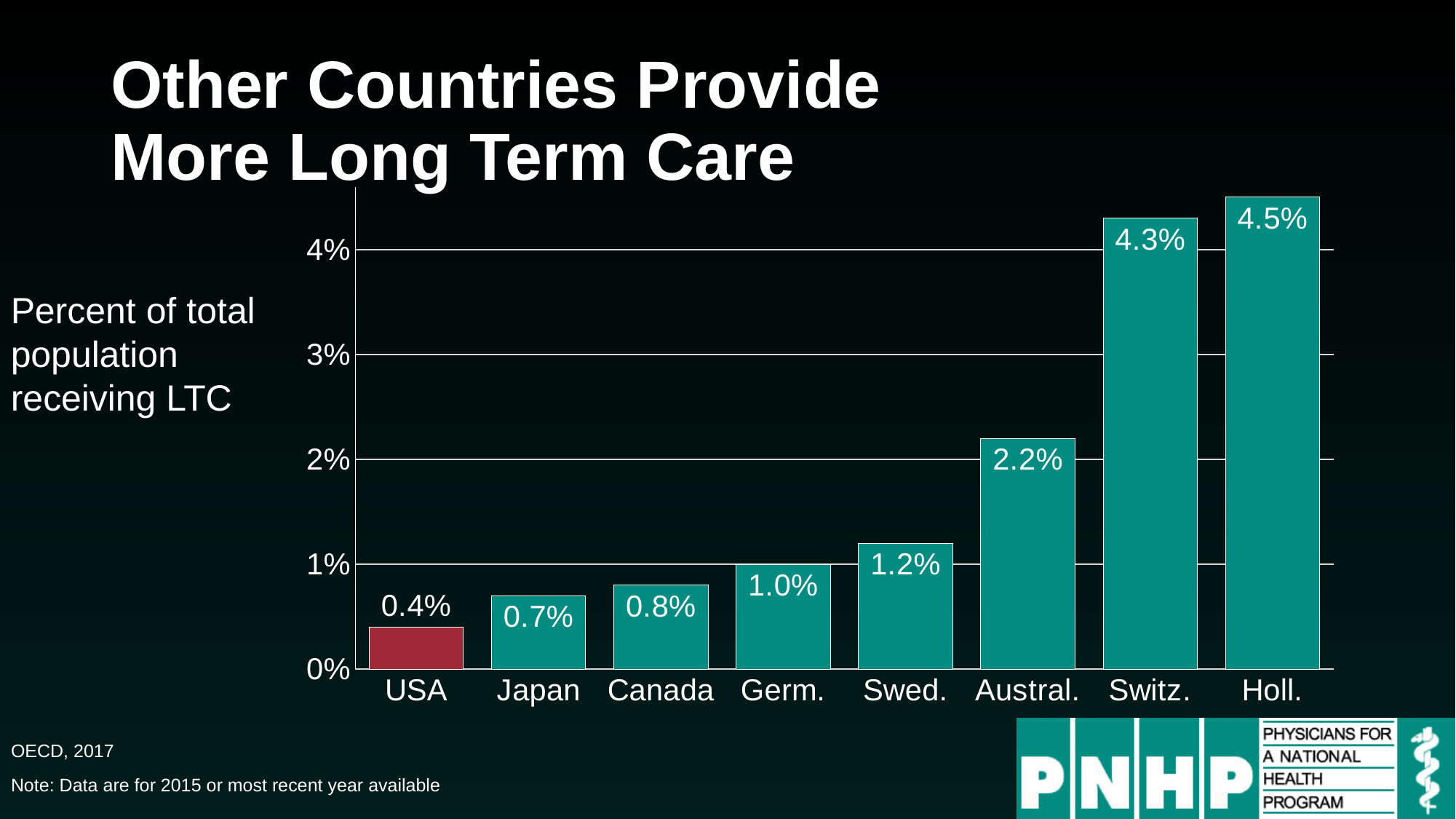
Which country has the lowest percent of population receiving LTC? USA Is the value for Germ. greater or less than 2%? less What is the difference between the values for Holl. and the USA? 4.1% Which bar is shown in a different colour from the others? USA What percent of the total population receives LTC in the USA? 0.4% What is the value shown for Switz.? 4.3% What is the value shown for Austral.? 2.2% Which has a higher value, Japan or Canada? Canada Which country has the highest percent of population receiving LTC? Holl. What is the difference between the values for Austral. and Swed.? 1.0% What kind of chart is shown on the slide? bar chart How many countries are shown in the chart? 8